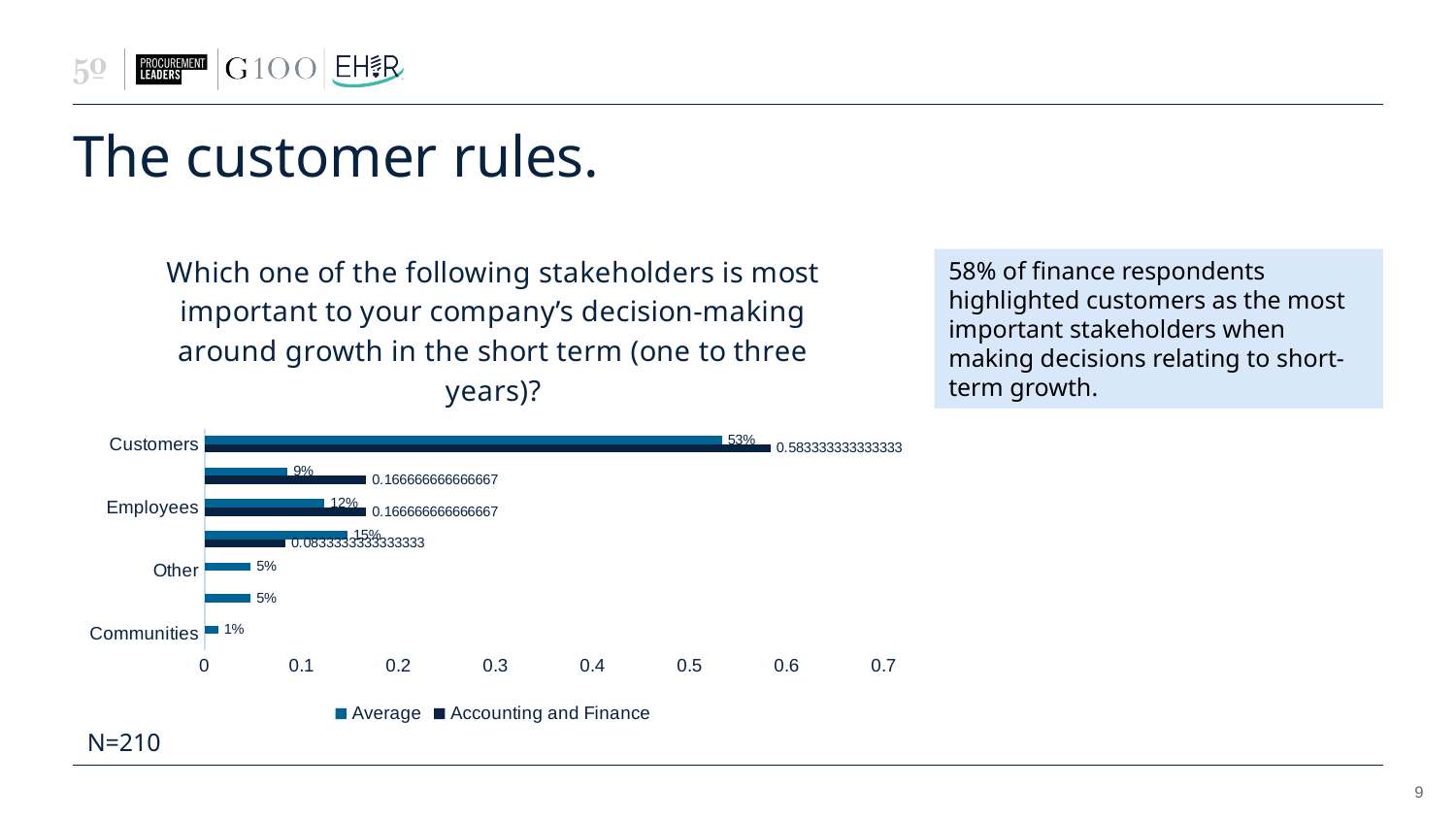
What is the Average value for Customers? 53% What are the two series named in the chart legend? Average and Accounting and Finance Which labeled category has the highest Average value? Customers What is the Accounting and Finance value for Employees? 0.166666666666667 What kind of chart is shown on the slide? Bar chart Is the Accounting and Finance value for Customers greater or less than 0.5? greater What is the Average value for Communities? 1% How many series does the chart legend list? 2 What is the Accounting and Finance value for Customers? 0.583333333333333 What is the Average value for Employees? 12% Which labeled category has the lowest Average value? Communities What is the Average value for Other? 5%